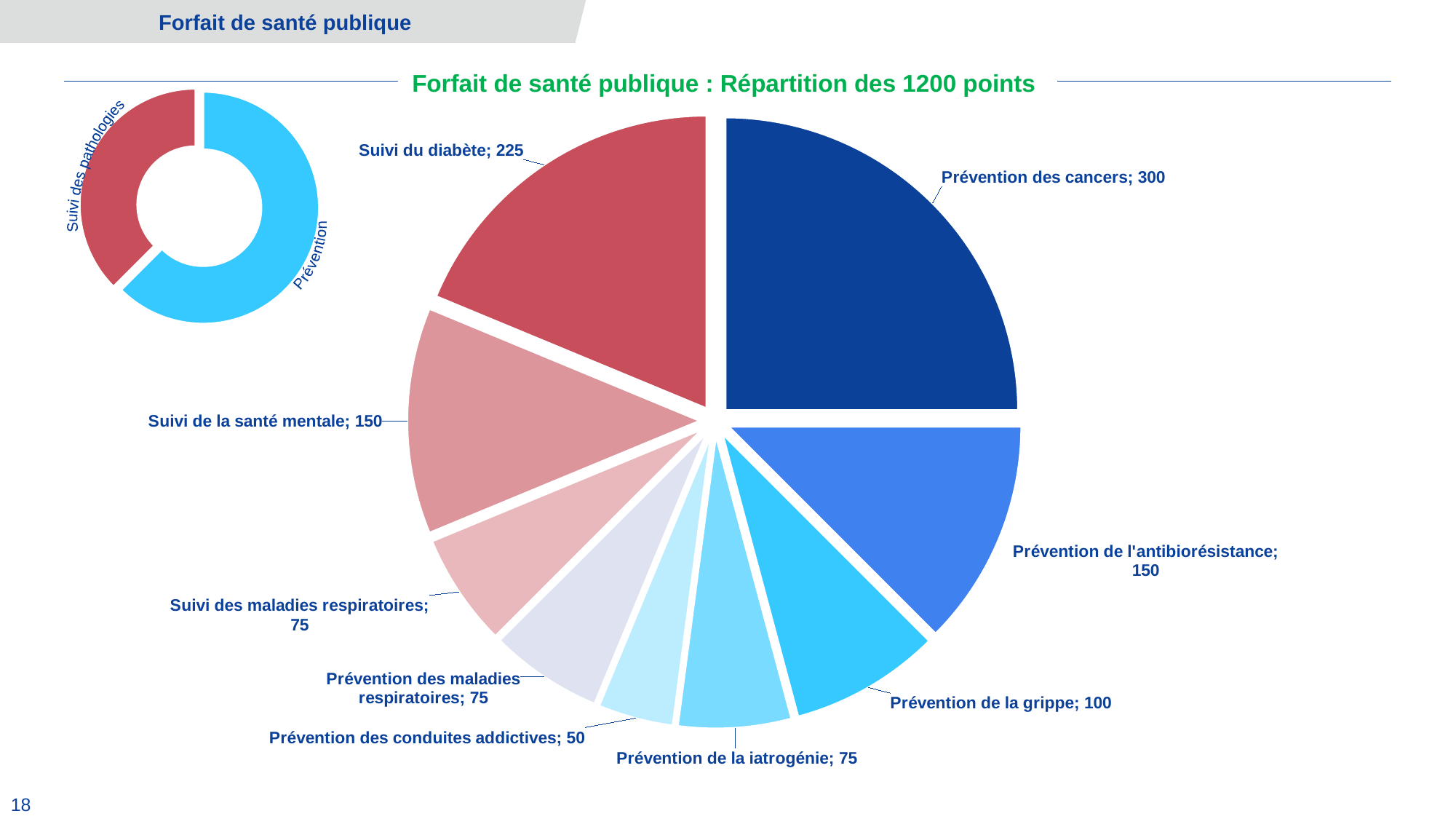
In the large pie chart, what is the difference in points between Prévention des cancers and Suivi du diabète? 75 What are the two categories shown in the small doughnut chart at the top left? Suivi des pathologies and Prévention In the large pie chart, how many points go to Prévention des conduites addictives? 50 How many slices does the large pie chart have? 9 In the large pie chart, what is the value for Suivi du diabète? 225 In the large pie chart, which category has the largest slice? Prévention des cancers In the large pie chart, how many points are allocated to Prévention des cancers? 300 In the large pie chart, which is larger: Prévention de la grippe or Suivi de la santé mentale? Suivi de la santé mentale In the large pie chart, what share of the 1200 points does Prévention des cancers represent? 25% In the large pie chart, which category has the smallest slice? Prévention des conduites addictives In the large pie chart, what share of the 1200 points does Prévention de l'antibiorésistance represent? 12.5% What type of chart is the large chart titled 'Forfait de santé publique : Répartition des 1200 points'? Pie chart